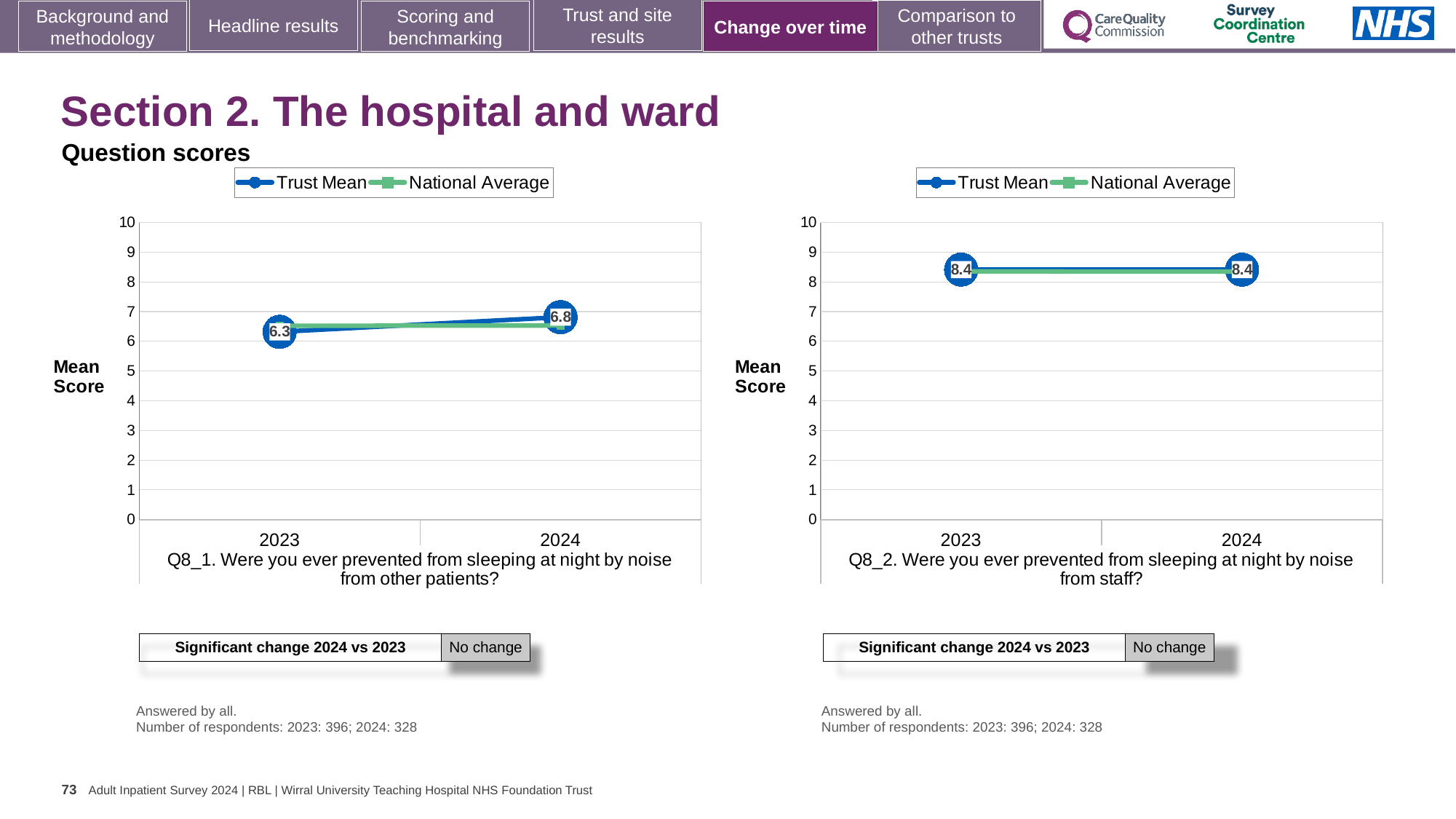
In the left chart (Q8_1), does the Trust Mean rise or fall from 2023 to 2024? rise In the right chart (Q8_2), what is the Trust Mean score for 2024? 8.4 In the left chart (Q8_1), by how much did the Trust Mean change from 2023 to 2024? 0.5 In the left chart (Q8_1), which year has the higher Trust Mean score? 2024 How many years are plotted on the x axis of the right chart (Q8_2)? 2 In the right chart (Q8_2), is the National Average for 2023 greater or less than 8? greater In the left chart (Q8_1), what is the Trust Mean score for 2024? 6.8 In the left chart (Q8_1), what is the Trust Mean score for 2023? 6.3 In the left chart (Q8_1), is the National Average for 2024 greater or less than 7? less What kind of chart is the left chart (Q8_1)? line chart How many series does the legend of the left chart (Q8_1) list? 2 In the right chart (Q8_2), does the Trust Mean rise, fall or stay the same from 2023 to 2024? stay the same